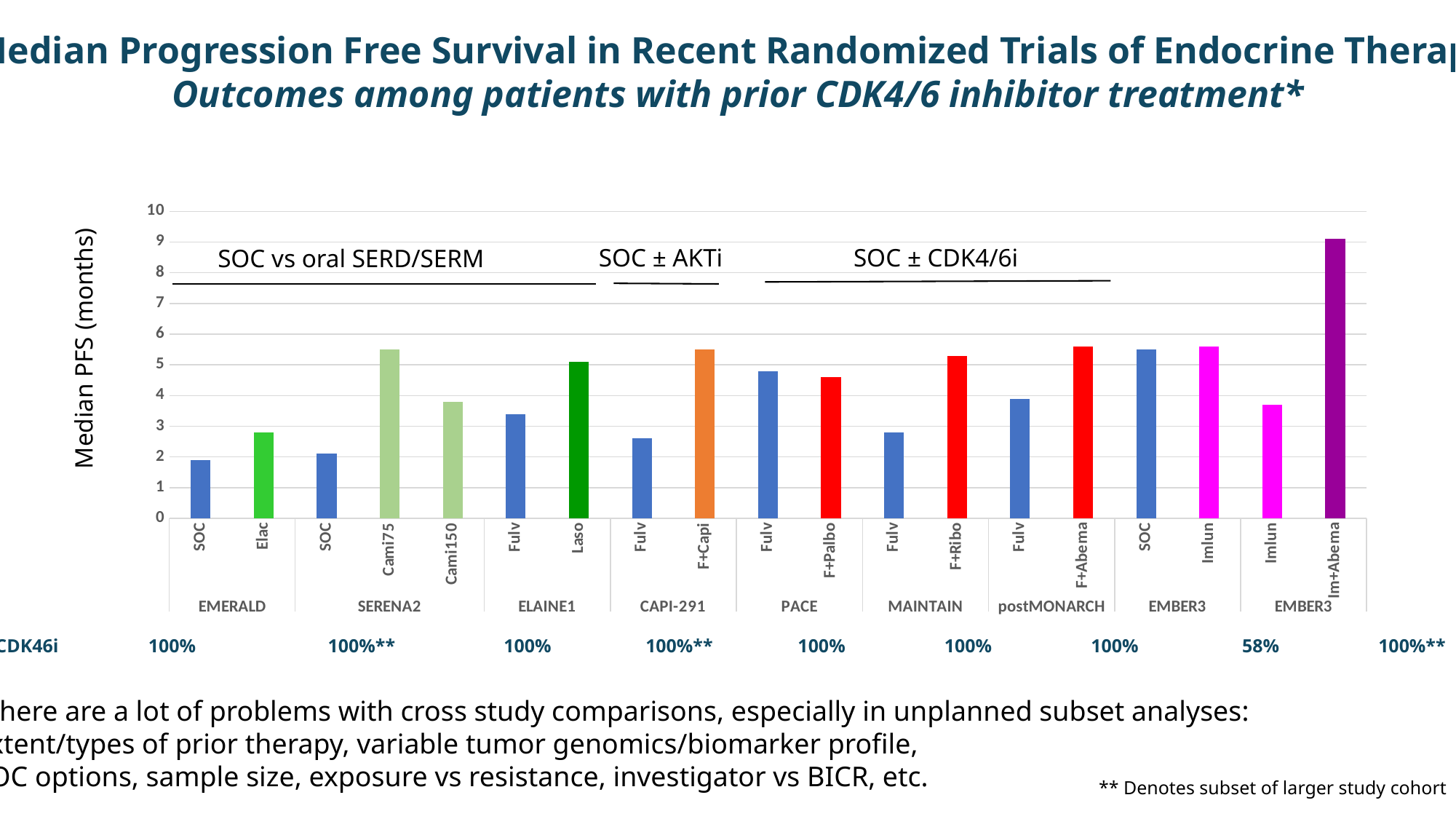
Is the median PFS for F+Ribo in MAINTAIN greater or less than 5 months? greater What kind of chart is shown on the slide? bar chart In SERENA2, which arm has the higher median PFS, Cami75 or Cami150? Cami75 In ELAINE1, which arm has the higher median PFS, Fulv or Laso? Laso How many bars are plotted on the chart? 19 What percentage is shown in the CDK46i row under the EMBER3 group with the Imlun and SOC arms? 58% What is the label on the y axis of the chart? Median PFS (months) Is the median PFS for Im+Abema in EMBER3 greater or less than 8 months? greater Is the median PFS for Cami75 in SERENA2 greater or less than 5 months? greater Which bar has the highest median PFS on the chart? Im+Abema (EMBER3) How many trial group labels appear along the x axis? 9